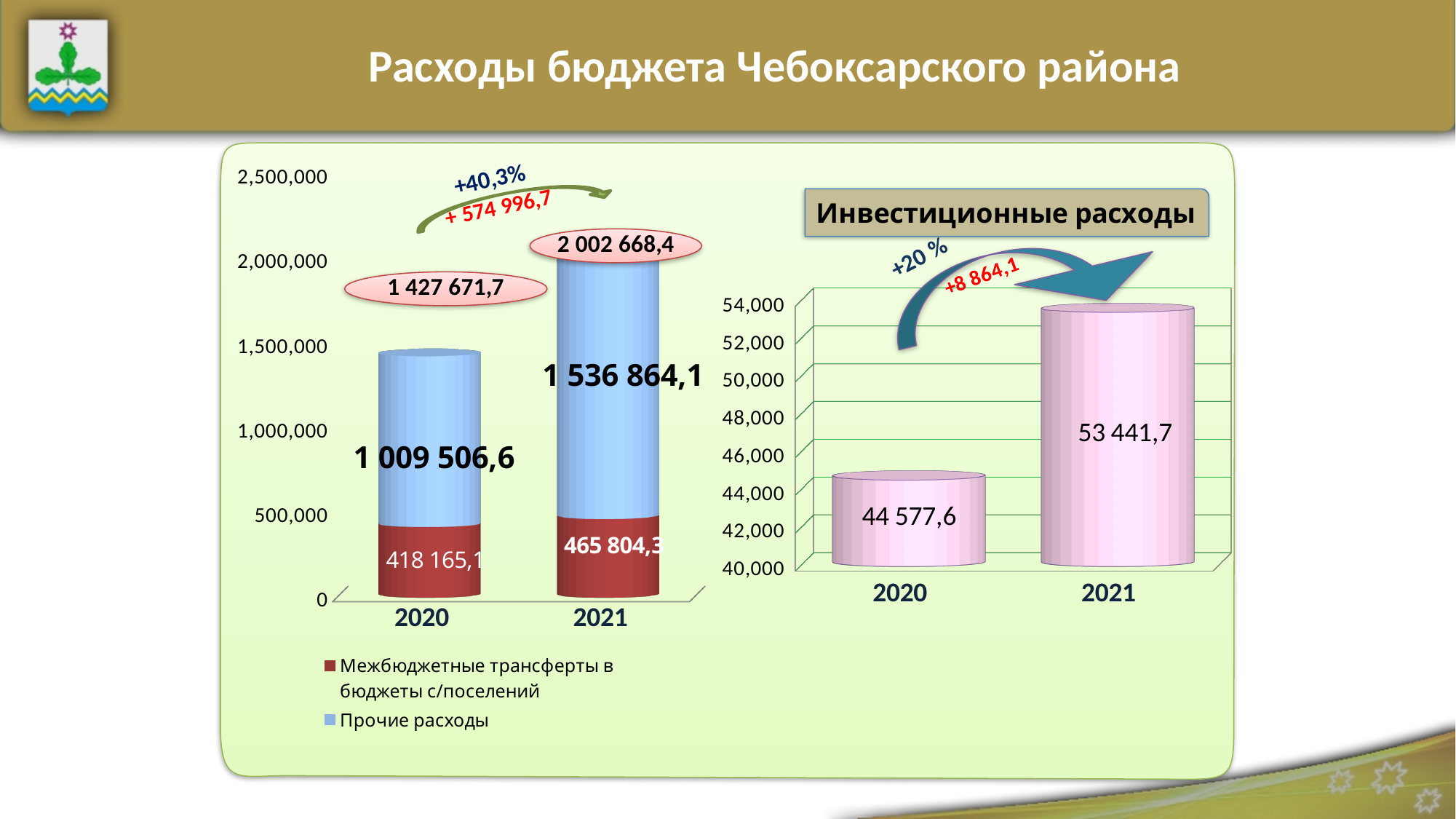
In the chart titled Инвестиционные расходы, what is the difference between the 2021 and 2020 values? 8 864,1 In the chart titled Инвестиционные расходы, what is the value for 2020? 44 577,6 In the chart titled Инвестиционные расходы, what is the value for 2021? 53 441,7 In the left stacked bar chart, what is the total of the 2021 bar? 2 002 668,4 In the left stacked bar chart, what is the total of the 2020 bar? 1 427 671,7 In the left stacked bar chart, what is the value of Межбюджетные трансферты в бюджеты с/поселений for 2020? 418 165,1 In the left stacked bar chart, how many series does the legend list? 2 What kind of chart is the one titled Инвестиционные расходы? bar chart In the chart titled Инвестиционные расходы, do the values rise or fall from 2020 to 2021? rise In the left stacked bar chart, what is the value of Прочие расходы for 2021? 1 536 864,1 In the left stacked bar chart, which year has the larger value for Межбюджетные трансферты в бюджеты с/поселений? 2021 In the left stacked bar chart, what is the difference between Прочие расходы in 2021 and in 2020? 527 357,5